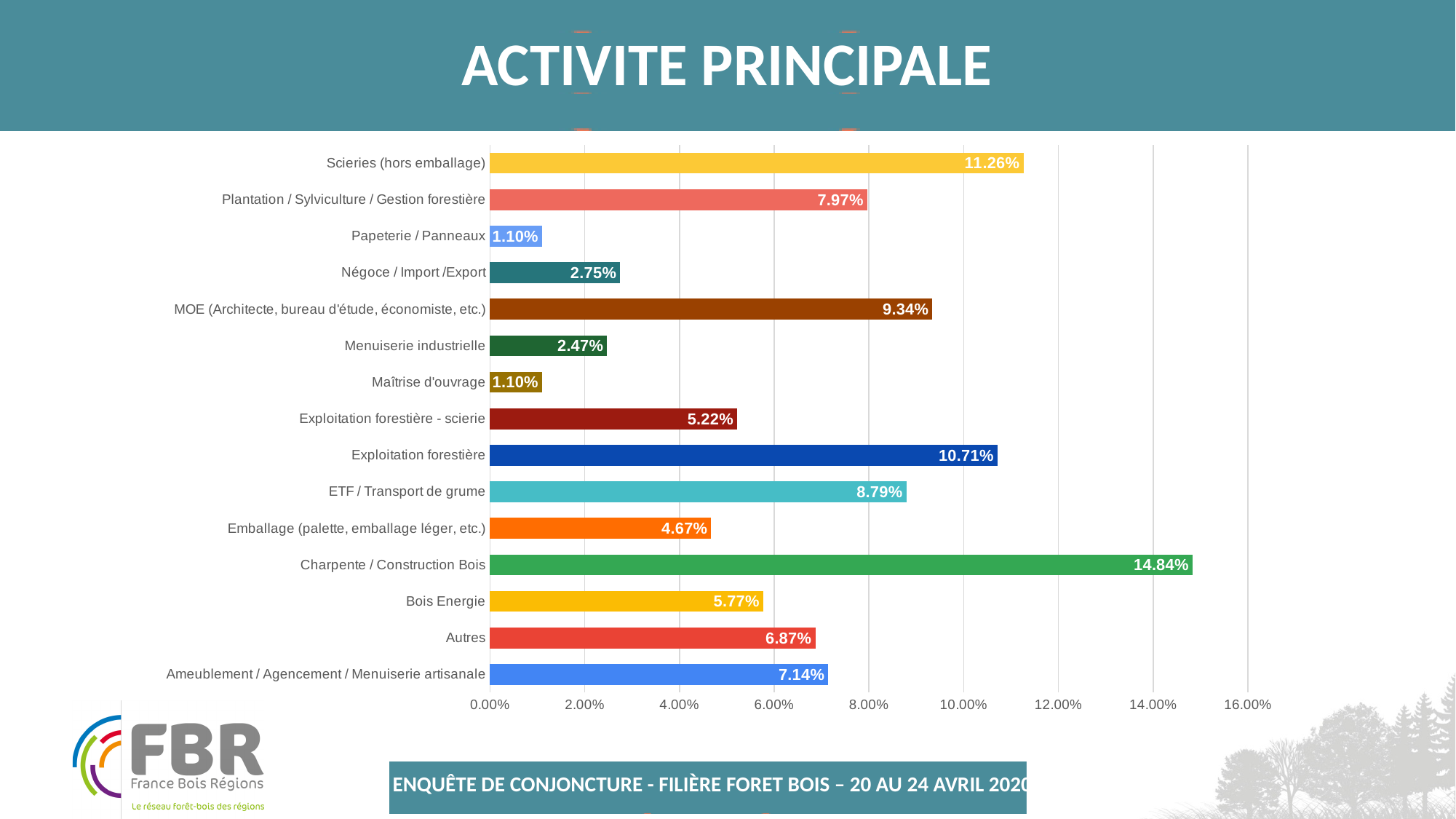
What is the value for Emballage (palette, emballage léger, etc.)? 4.67% What is the value for ETF / Transport de grume? 8.79% What is the difference between Exploitation forestière and Exploitation forestière - scierie? 5.49% How many categories are shown in the chart? 15 What is the difference between Scieries (hors emballage) and Plantation / Sylviculture / Gestion forestière? 3.29% What is the value for Exploitation forestière? 10.71% What is the title of the slide? ACTIVITE PRINCIPALE What kind of chart is shown on the slide? bar chart Which is larger, MOE (Architecte, bureau d'étude, économiste, etc.) or Autres? MOE (Architecte, bureau d'étude, économiste, etc.) Which category has the highest value? Charpente / Construction Bois What is the value for Charpente / Construction Bois? 14.84% Is the value for Bois Energie greater or less than 4.00%? greater